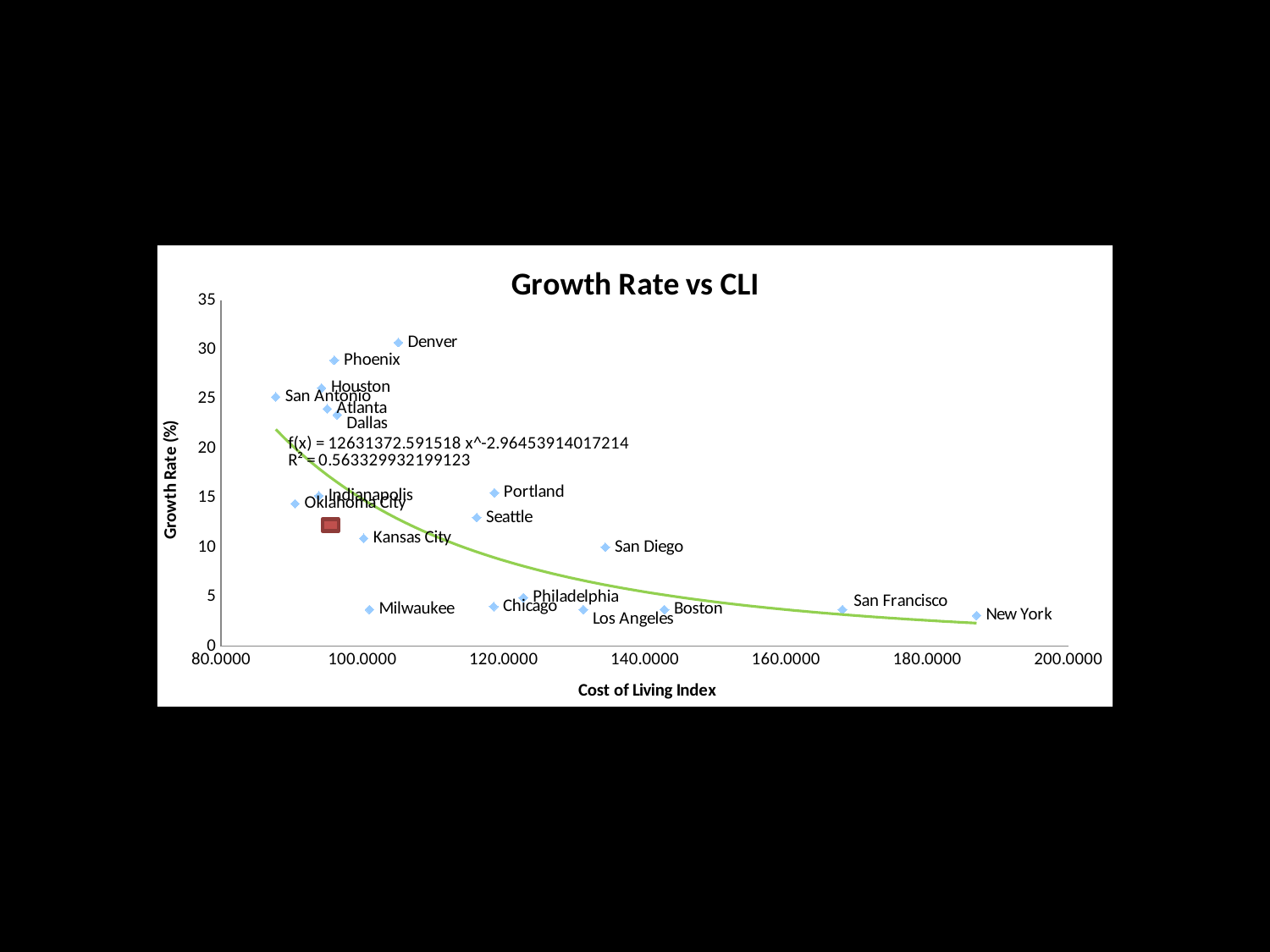
Is the growth rate for San Diego greater or less than 15? less Is the Cost of Living Index for New York greater or less than 180.0000? greater What is the label of the x axis? Cost of Living Index Which city has the higher growth rate, Denver or Milwaukee? Denver What kind of chart is shown on the slide? scatter chart What is the title of the chart? Growth Rate vs CLI Which city has the highest Cost of Living Index? New York Which city has the lowest Cost of Living Index? San Antonio Does the growth rate generally rise or fall as the Cost of Living Index increases? fall Which city has the higher Cost of Living Index, San Francisco or Seattle? San Francisco Which city has the highest growth rate? Denver Is the growth rate for Portland greater or less than 10? greater